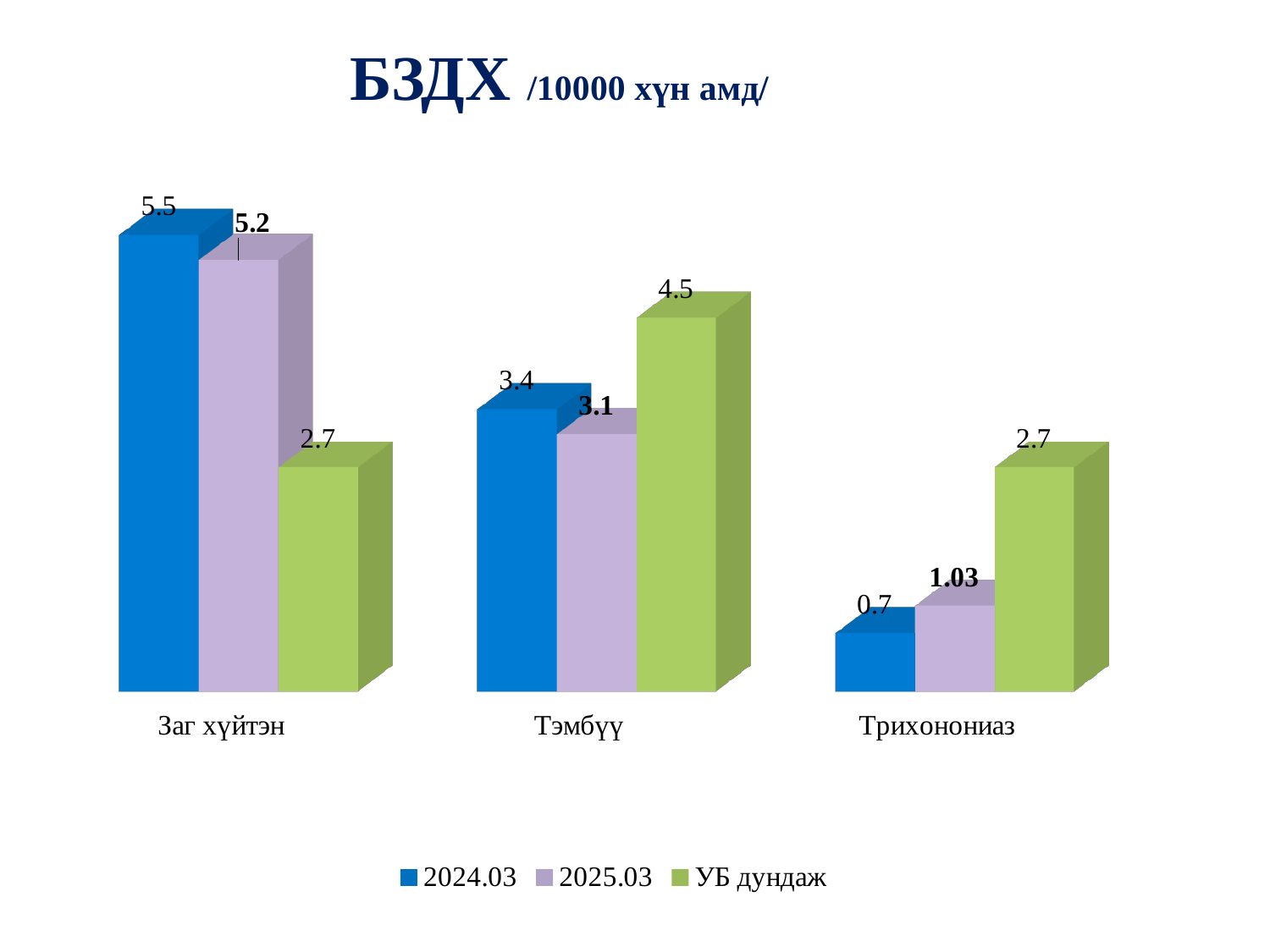
How many series does the legend list? 3 What is the difference between the 2024.03 and 2025.03 values for Заг хүйтэн? 0.3 What kind of chart is shown on the slide? Bar chart What is the УБ дундаж value for Трихонониаз? 2.7 What is the title of the chart? БЗДХ /10000 хүн амд/ Which category has the highest value in the 2024.03 series? Заг хүйтэн What is the value for Тэмбүү in the 2025.03 series? 3.1 Which category has the lowest value in the УБ дундаж series? Заг хүйтэн and Трихонониаз (both 2.7) What is the value for Трихонониаз in the 2025.03 series? 1.03 What is the value for Заг хүйтэн in the 2024.03 series? 5.5 For Тэмбүү, which is larger: the 2025.03 value or the УБ дундаж value? УБ дундаж How many categories are shown on the x axis? 3